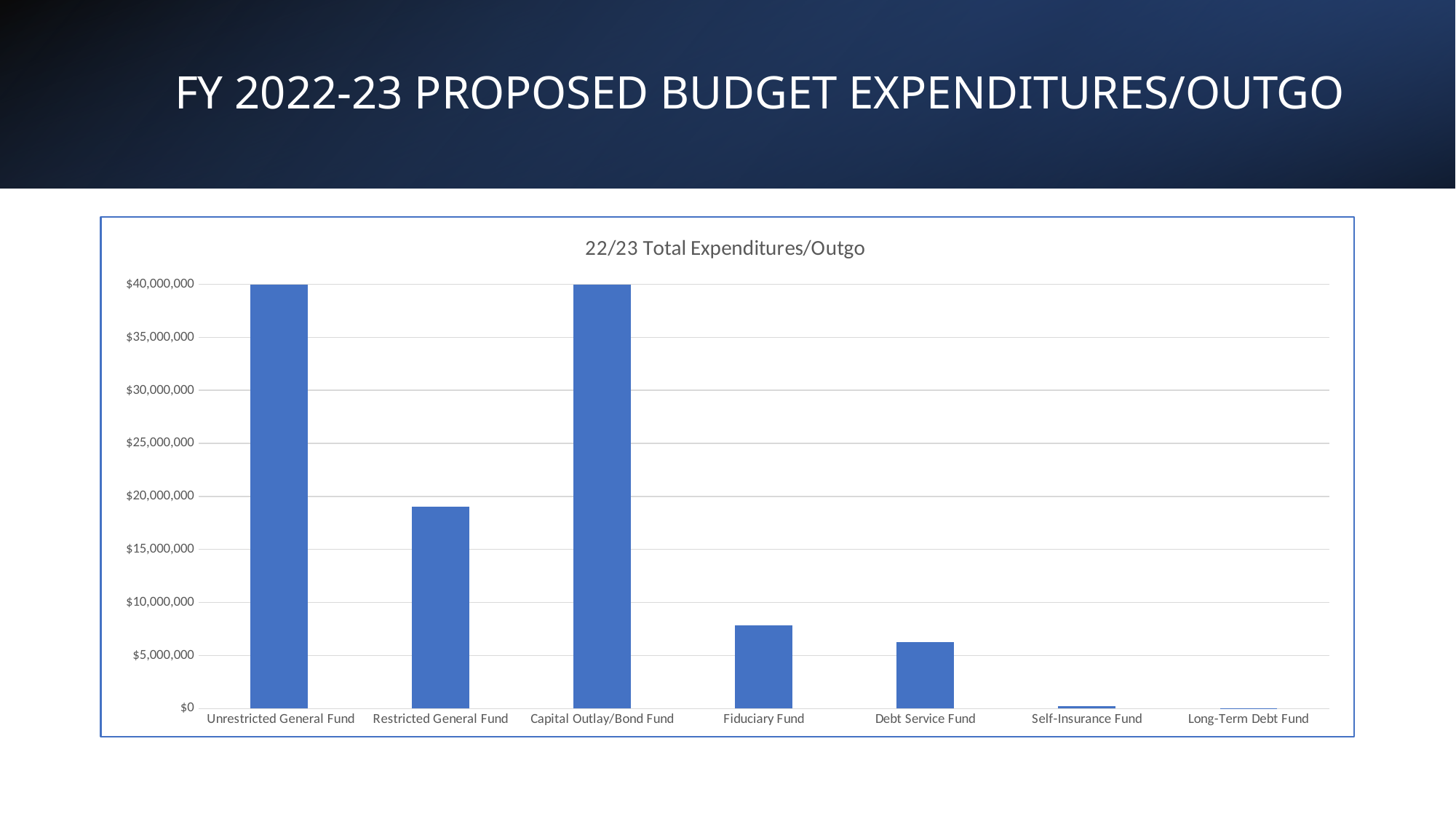
Is the value for Self-Insurance Fund greater or less than $5,000,000? less Is the value for Fiduciary Fund greater or less than $10,000,000? less Is the value for Fiduciary Fund greater or less than $5,000,000? greater What is the title of the chart? 22/23 Total Expenditures/Outgo How many fund categories are plotted on the chart? 7 Which is larger, the value for Fiduciary Fund or the value for Debt Service Fund? Fiduciary Fund Which is larger, the value for Restricted General Fund or the value for Fiduciary Fund? Restricted General Fund What kind of chart is shown on the slide? bar chart Which fund has the lowest expenditures/outgo on the chart? Long-Term Debt Fund